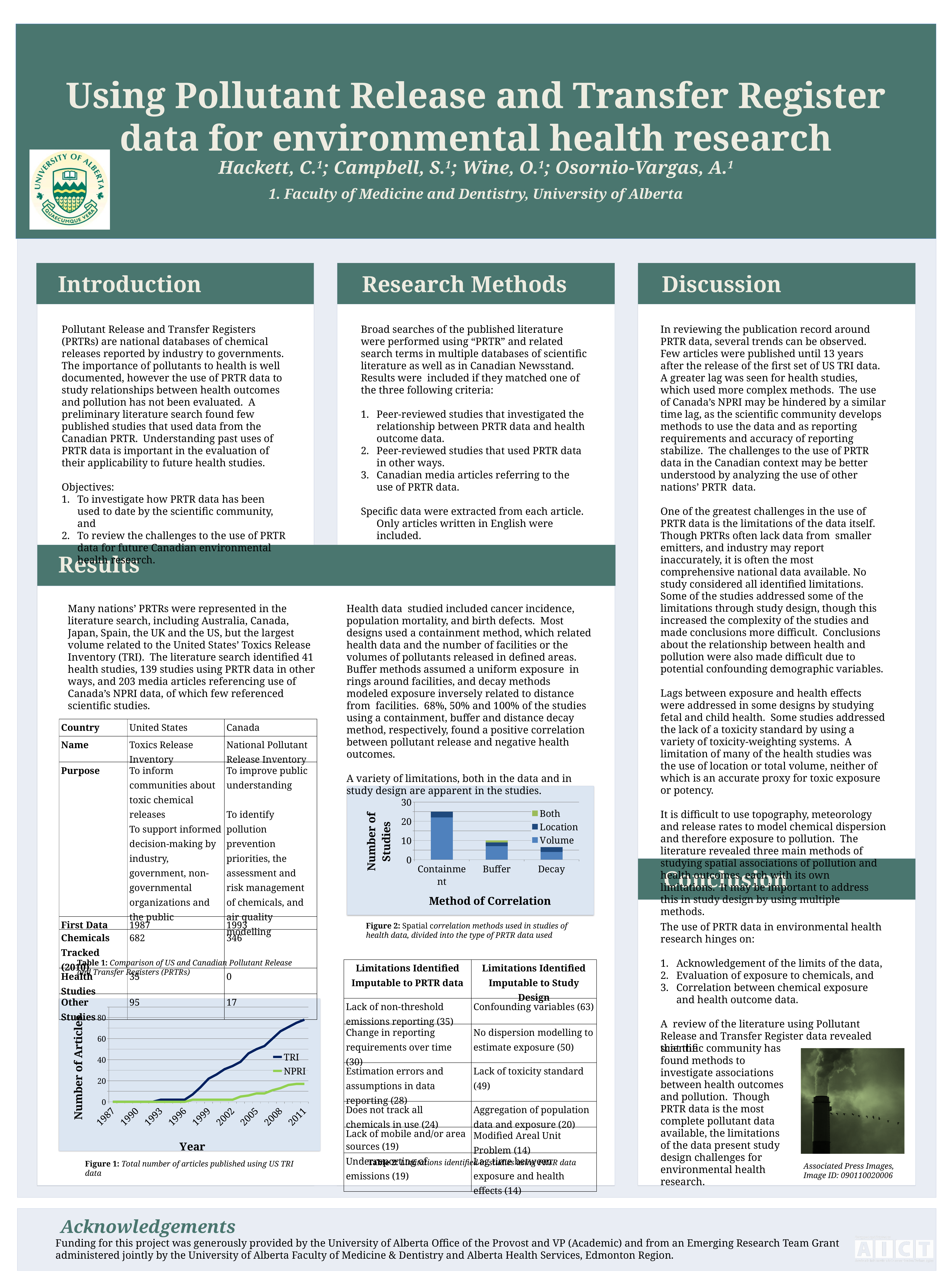
In Figure 2 (Method of Correlation chart), is the total number of studies for Decay greater or less than 10? less In Figure 2 (Method of Correlation chart), is the total number of studies for Buffer greater or less than 20? less In Figure 2 (Method of Correlation chart), which method has the highest total number of studies? Containment In Figure 1 (Number of Articles by Year chart), which series has the larger value in 2011, TRI or NPRI? TRI In Figure 2 (Method of Correlation chart), what is the title of the x axis? Method of Correlation In Figure 2 (Method of Correlation chart), how many series does the legend list? 3 In Figure 1 (Number of Articles by Year chart), does the number of TRI articles rise or fall from 1987 to 2011? rise In Figure 1 (Number of Articles by Year chart), what kind of chart is shown? line chart In Figure 2 (Method of Correlation chart), what kind of chart is shown? bar chart In Figure 1 (Number of Articles by Year chart), how many series does the legend list? 2 In Figure 2 (Method of Correlation chart), is the total number of studies for Containment greater or less than 20? greater In Figure 2 (Method of Correlation chart), how many methods of correlation are shown on the x axis? 3